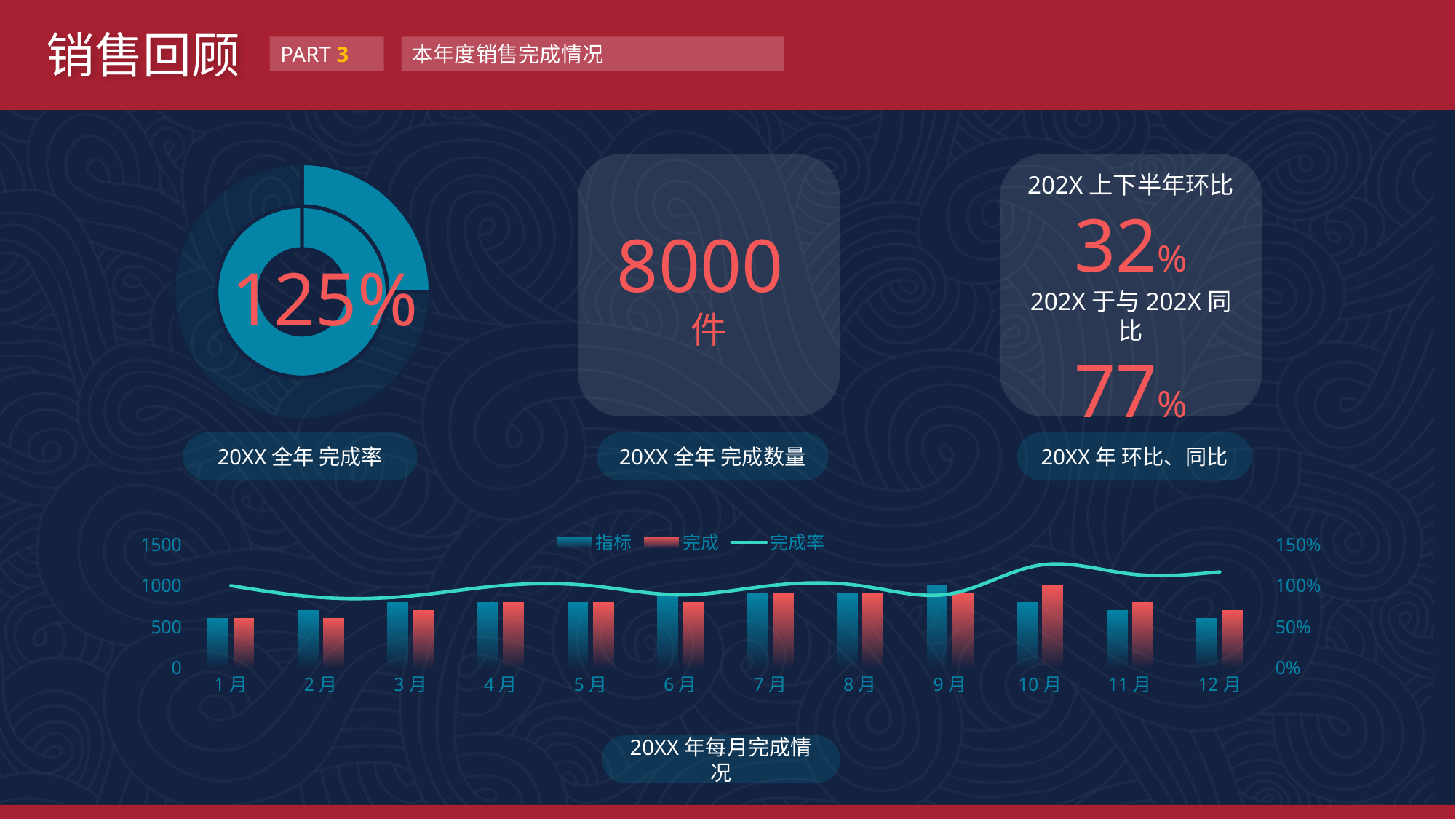
In the bottom chart (20XX 年每月完成情况), is the 完成率 value for 1 月 greater or less than 150%? less In the bottom chart (20XX 年每月完成情况), how many series does the legend list? 3 What kind of chart is the bottom chart (20XX 年每月完成情况)? A bar chart combined with a line chart In the bottom chart (20XX 年每月完成情况), which series is drawn as a line rather than bars? 完成率 In the bottom chart (20XX 年每月完成情况), which month has the highest 指标 bar? 9 月 In the bottom chart (20XX 年每月完成情况), is the 指标 value for 1 月 greater or less than 1000? less In the bottom chart (20XX 年每月完成情况), is the 完成率 value for 10 月 greater or less than 100%? greater In the bottom chart (20XX 年每月完成情况), which month has the highest 完成 bar? 10 月 In the bottom chart (20XX 年每月完成情况), how many months are shown on the x axis? 12 In the bottom chart (20XX 年每月完成情况), for 10 月, which is larger: the 指标 bar or the 完成 bar? 完成 In the bottom chart (20XX 年每月完成情况), for 2 月, which is larger: the 指标 bar or the 完成 bar? 指标